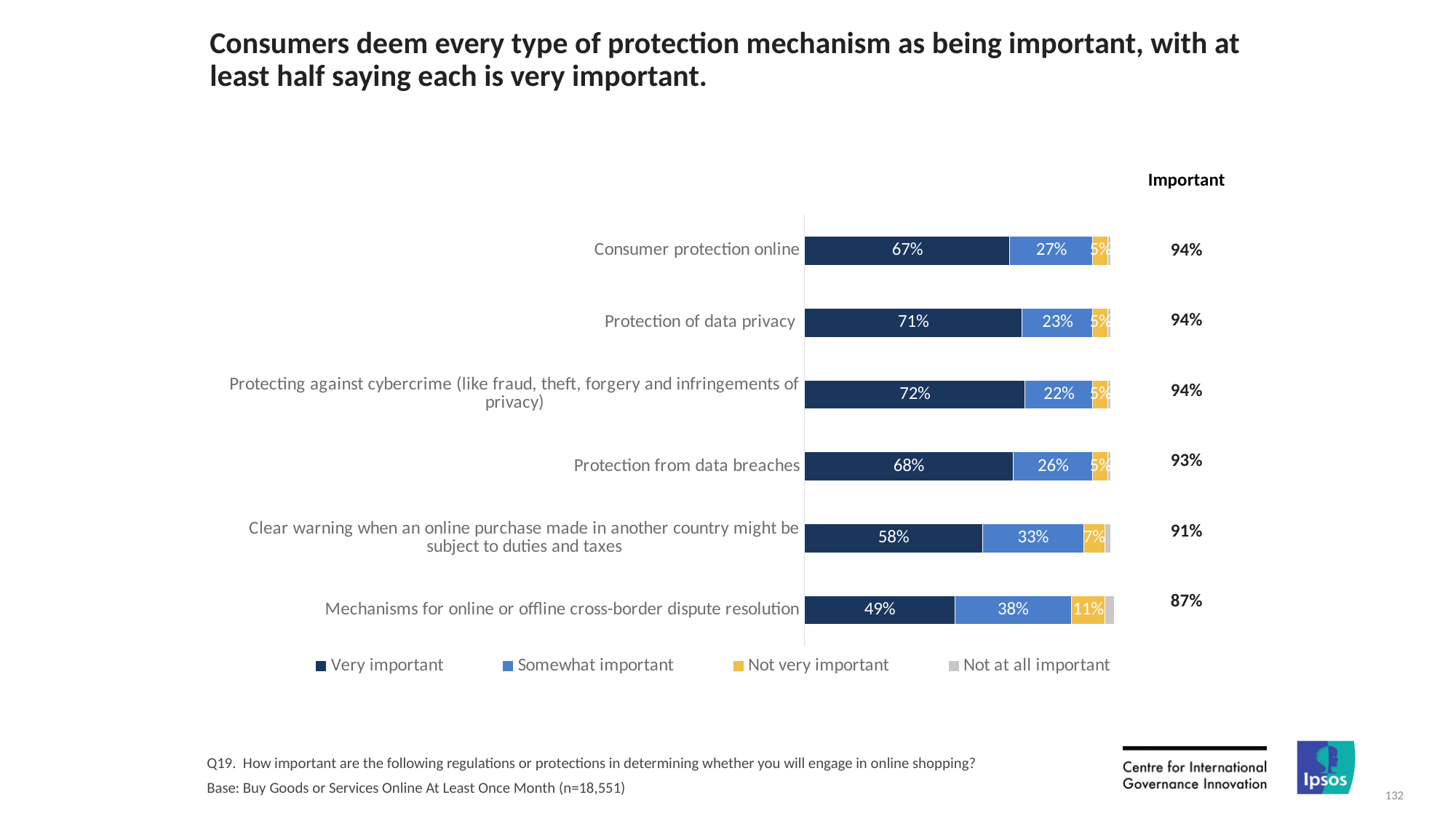
What percentage of respondents rate 'Protection of data privacy' as very important? 71% How many series does the legend list? 4 How many categories are shown in the chart? 6 Which category has the lowest 'Very important' percentage? Mechanisms for online or offline cross-border dispute resolution What is the 'Not very important' percentage for 'Mechanisms for online or offline cross-border dispute resolution'? 11% What is the difference between the 'Very important' percentages for 'Protection of data privacy' and 'Consumer protection online'? 4% What kind of chart is shown on the slide? Stacked bar chart Which has a larger 'Somewhat important' share: 'Protection from data breaches' or 'Protecting against cybercrime'? Protection from data breaches What is the 'Important' total shown for 'Clear warning when an online purchase made in another country might be subject to duties and taxes'? 91% Which category has the highest 'Very important' percentage? Protecting against cybercrime (like fraud, theft, forgery and infringements of privacy) Which colour represents 'Not very important' in the legend? Yellow What percentage of respondents rate 'Mechanisms for online or offline cross-border dispute resolution' as somewhat important? 38%